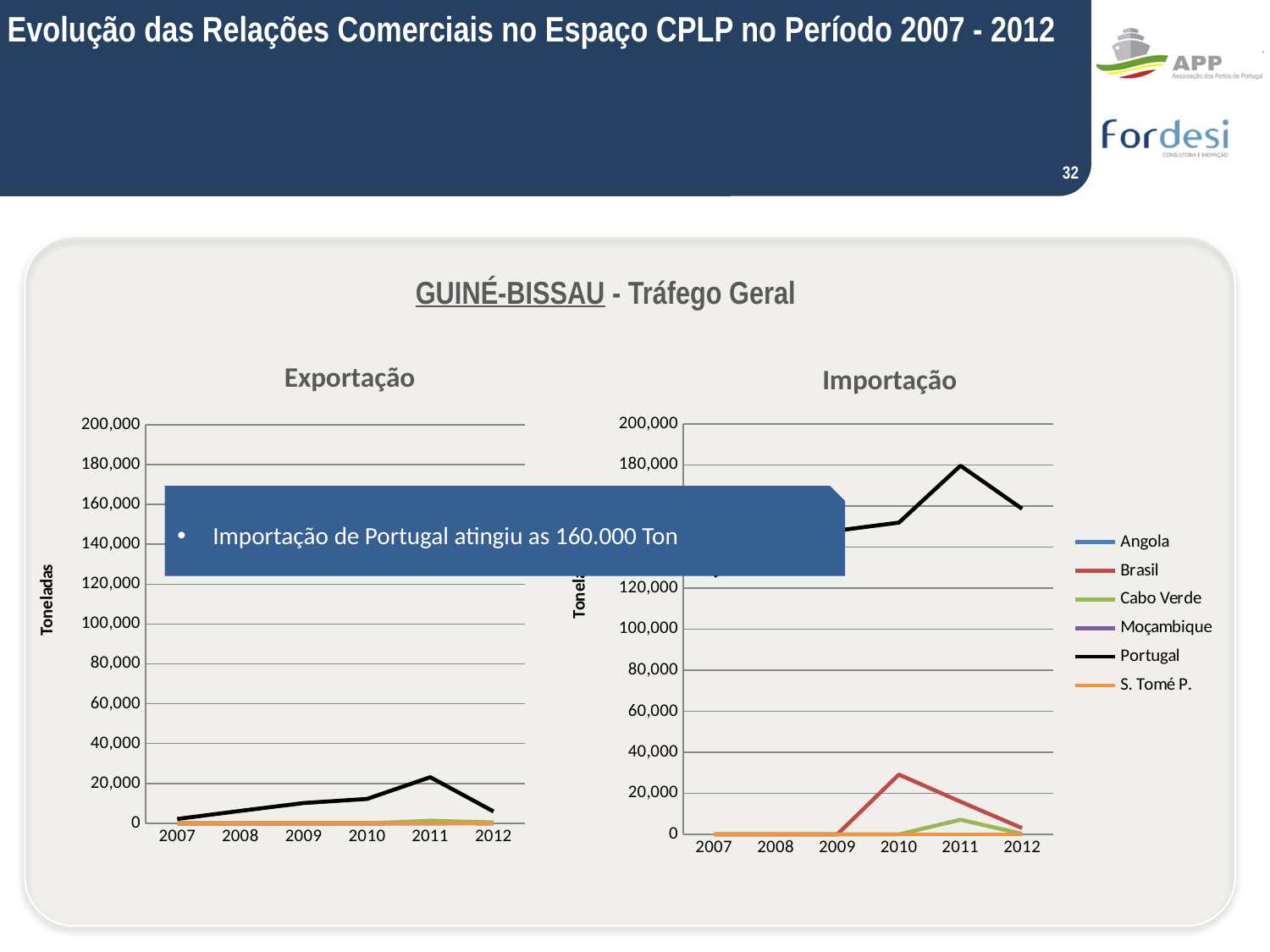
How many series does the legend list for the Importação chart? 6 In the Exportação chart, does the value for Portugal rise or fall from 2011 to 2012? fall In the Importação chart, in which year does Portugal reach its highest value? 2011 What kind of chart is the Exportação chart? line chart In the Exportação chart, is the value for Portugal in 2012 greater or less than 20,000? less What is the label on the y axis of the Exportação chart? Toneladas In the Importação chart, is the value for Brasil in 2010 greater or less than 20,000? greater How many years are shown on the x axis of the Exportação chart? 6 In the Importação chart, which series has the highest value in 2010, Brasil or Portugal? Portugal In the Importação chart, is the value for Portugal in 2011 greater or less than 160,000? greater In the Exportação chart, in which year does Portugal reach its highest value? 2011